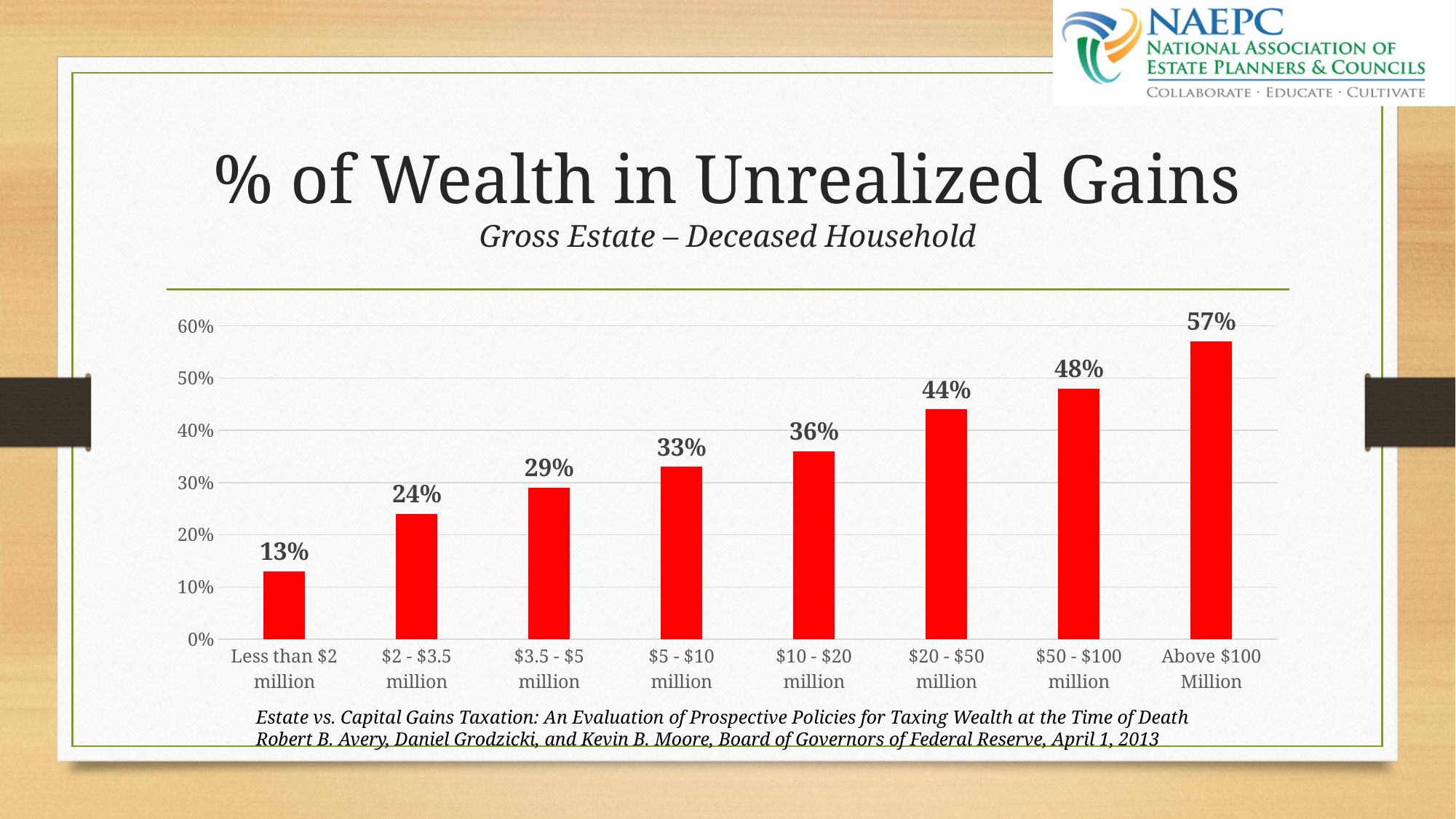
Is the value for "$20 - $50 million" greater or less than 40%? greater What is the difference between the values for "Above $100 Million" and "Less than $2 million"? 44% Which category has the highest % of wealth in unrealized gains? Above $100 Million Which is larger, the value for "$5 - $10 million" or the value for "$2 - $3.5 million"? $5 - $10 million What is the % of wealth in unrealized gains for the "Less than $2 million" category? 13% What is the value shown for the "$50 - $100 million" category? 48% What kind of chart is shown on the slide? Bar chart Do the values rise or fall as the estate size categories increase from left to right? Rise How many estate size categories are shown on the chart? 8 What is the difference between the values for "$20 - $50 million" and "$3.5 - $5 million"? 15% What is the value shown for the "$10 - $20 million" category? 36% Which category has the lowest % of wealth in unrealized gains? Less than $2 million